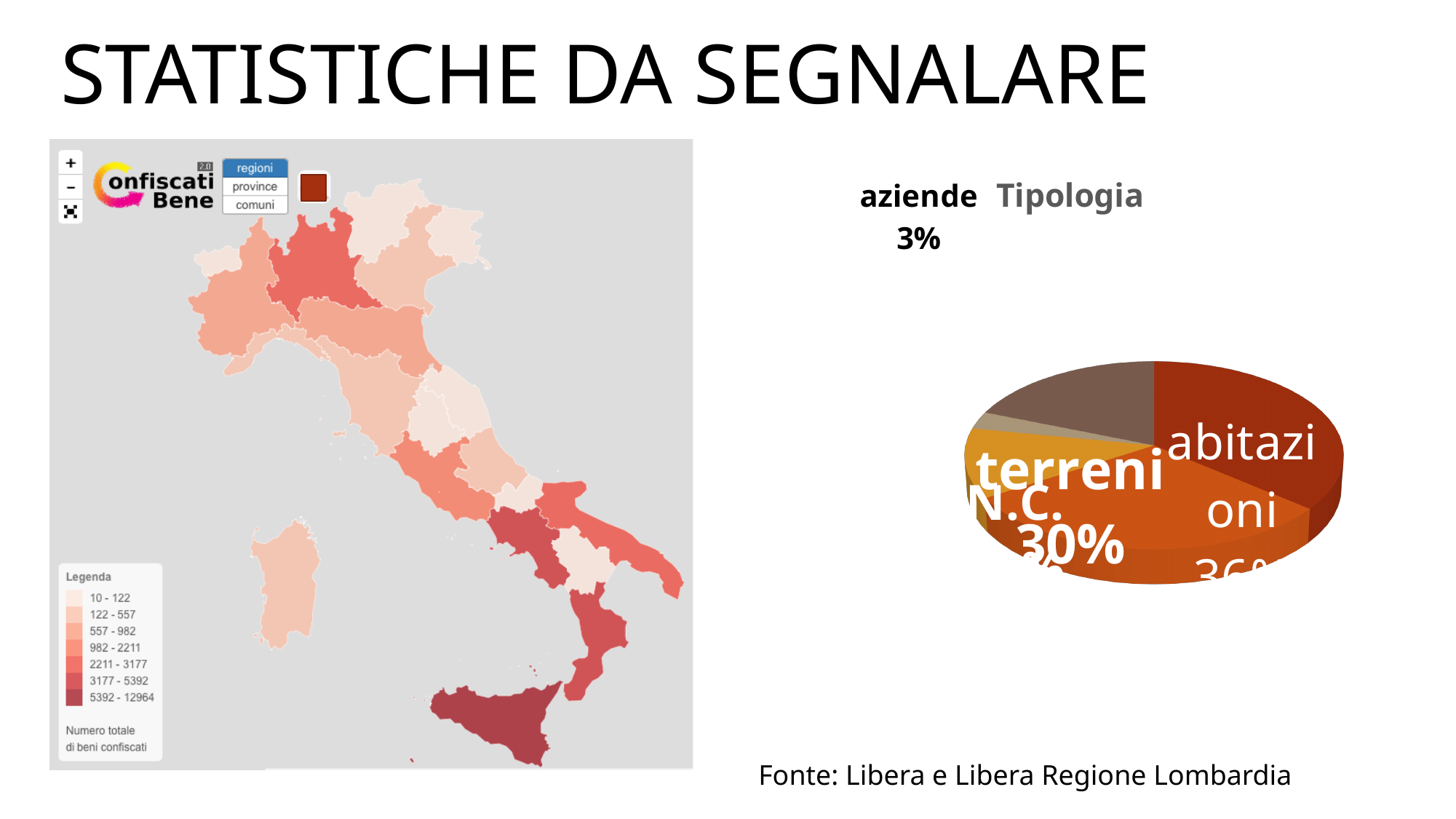
In the 'Tipologia' pie chart, which is larger: the share for terreni or the share for aziende? terreni What is the title of the pie chart on the slide? Tipologia In the 'Tipologia' pie chart, what percentage is shown for terreni? 30% In the 'Tipologia' pie chart, how many percentage points larger is terreni than aziende? 27 percentage points How many categories are shown in the 'Tipologia' pie chart? 5 What kind of chart is the 'Tipologia' chart on the right of the slide? pie chart In the 'Tipologia' pie chart, which category has the largest slice? abitazioni In the 'Tipologia' pie chart, what percentage is shown for aziende? 3% According to the text below the pie chart, what is the source of the data? Libera e Libera Regione Lombardia In the 'Tipologia' pie chart, which category has the smallest slice? aziende